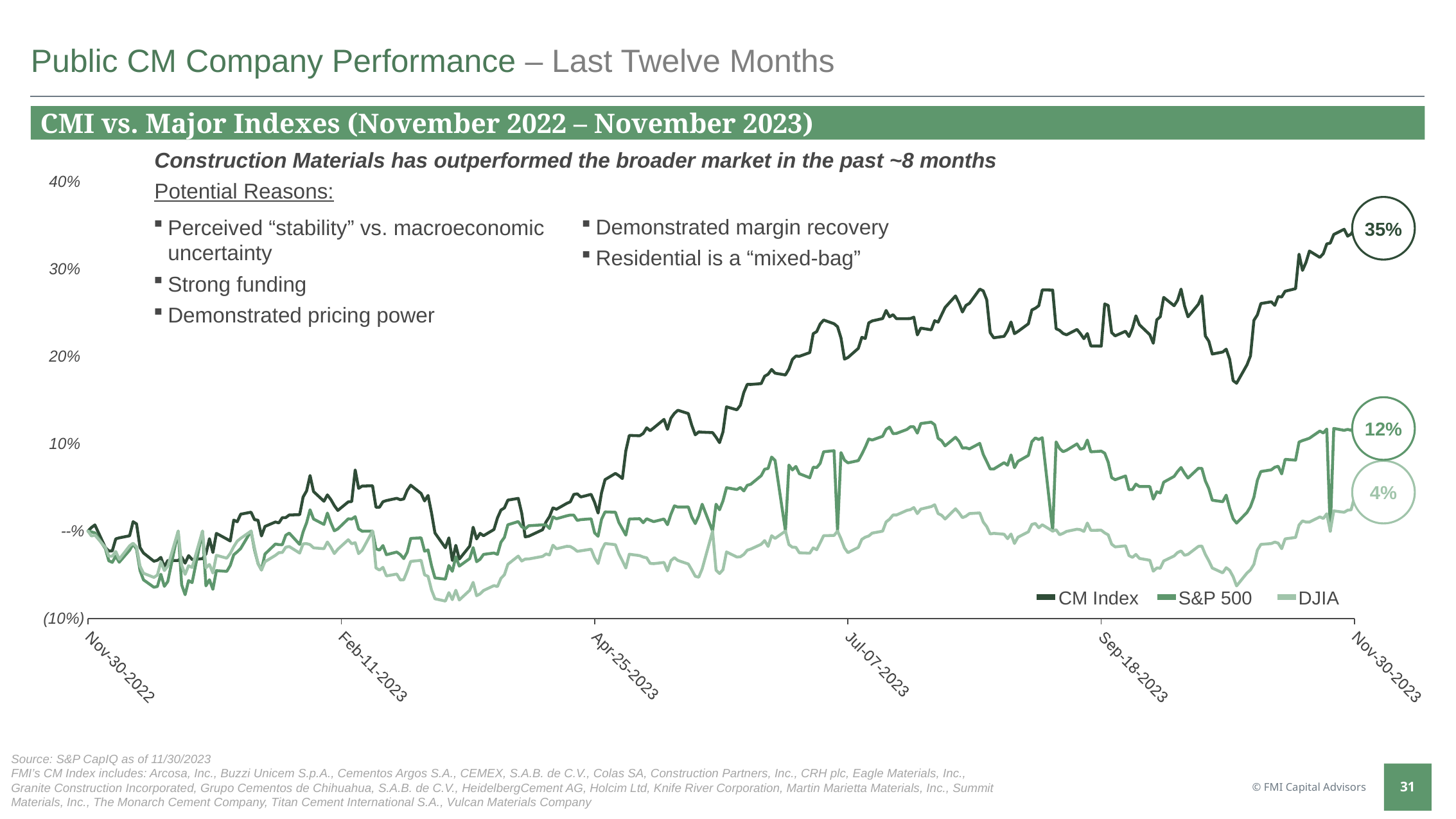
What is the labelled ending value of the DJIA at Nov-30-2023? 4% What is the labelled ending value of the S&P 500 at Nov-30-2023? 12% How many series does the chart legend list? 3 By how many percentage points does the CM Index's ending value exceed the S&P 500's ending value? 23 percentage points What kind of chart is shown on the slide? line chart Does the CM Index line generally rise or fall from Nov-30-2022 to Nov-30-2023? rise Which series has the highest labelled value at the end of the period? CM Index At the end of the period, which is larger: the S&P 500 value or the DJIA value? S&P 500 Which series has the lowest labelled value at the end of the period? DJIA What is the title of the chart section on the slide? CMI vs. Major Indexes (November 2022 – November 2023) What is the labelled ending value of the CM Index at Nov-30-2023? 35%